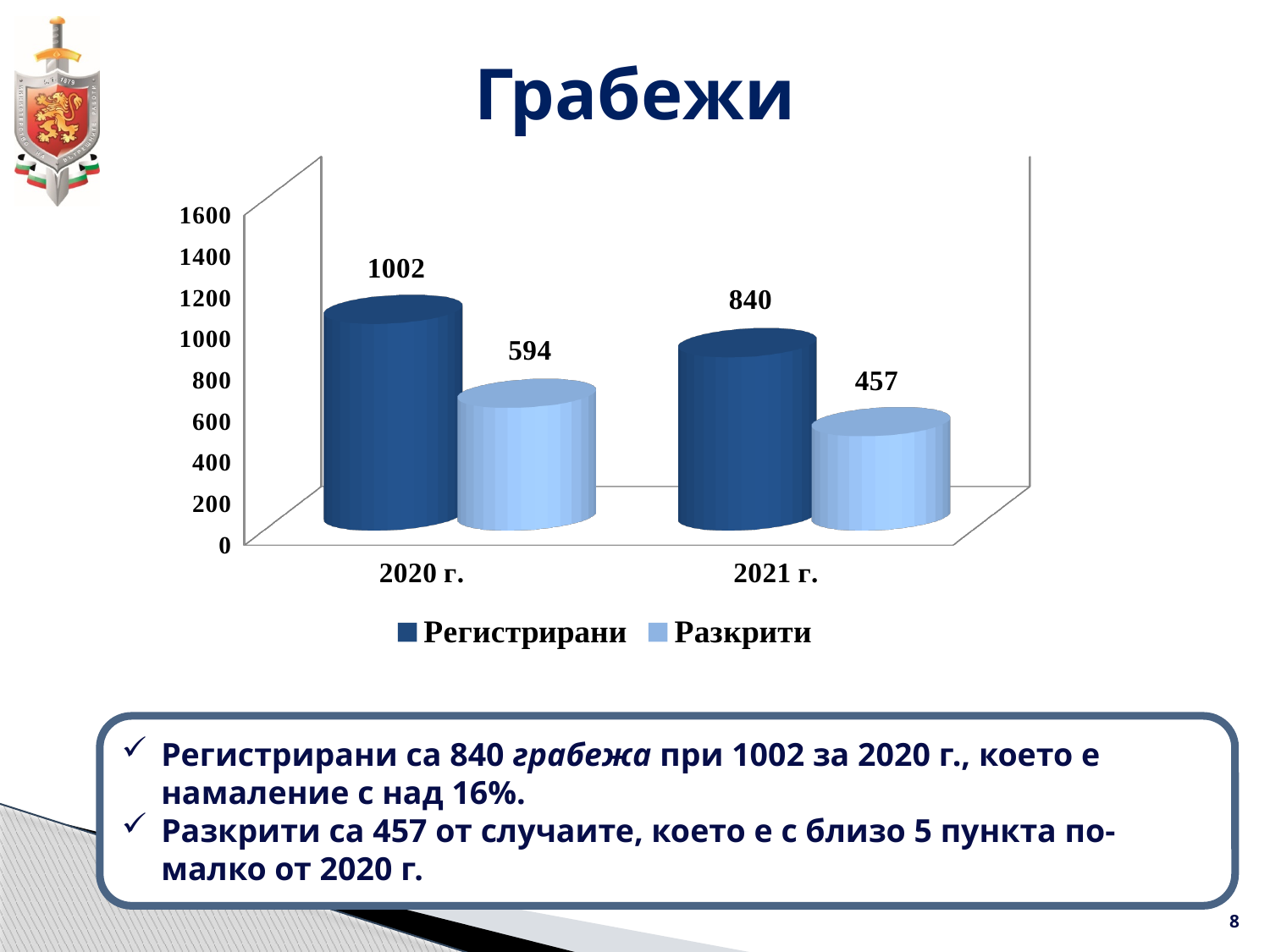
What is the difference between Регистрирани in 2020 г. and Регистрирани in 2021 г.? 162 What is the value for Разкрити in 2020 г.? 594 What kind of chart is shown on the slide? Bar chart What is the value for Разкрити in 2021 г.? 457 Which year has the lower value for Разкрити? 2021 г. Which is larger: Разкрити in 2020 г. or Разкрити in 2021 г.? Разкрити in 2020 г. Which year has the higher value for Регистрирани? 2020 г. What is the difference between Регистрирани and Разкрити in 2021 г.? 383 What is the value for Регистрирани in 2020 г.? 1002 How many series does the legend list? 2 Do the values for Регистрирани rise or fall from 2020 г. to 2021 г.? Fall What is the value for Регистрирани in 2021 г.? 840